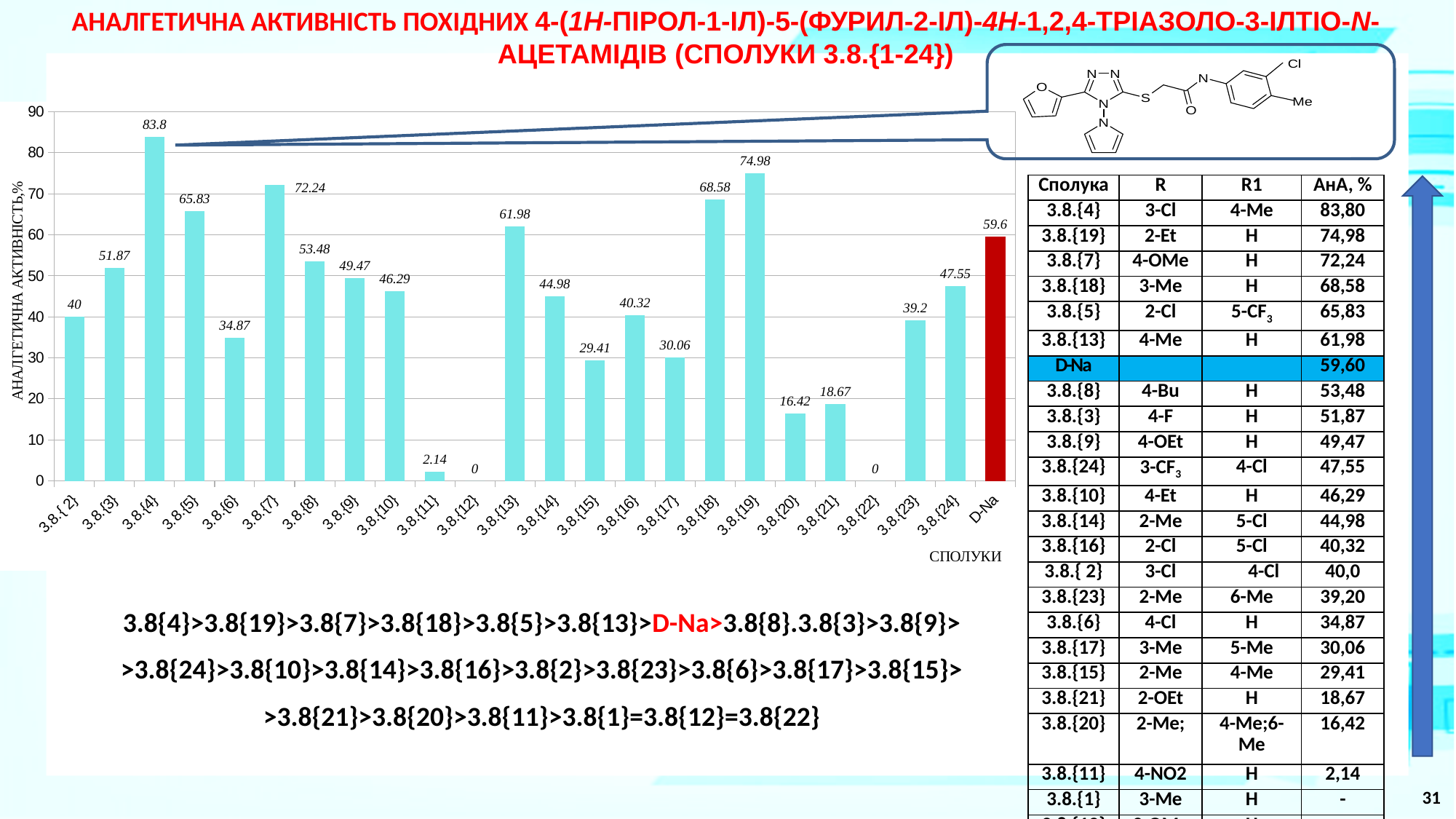
How many bars are plotted in the chart? 24 Which bar is coloured dark red instead of light blue? D-Na What kind of chart is shown? bar chart What is the value for 3.8.{19}? 74.98 Is the value for 3.8.{13} greater or less than 60? greater What is the difference between the values for 3.8.{4} and D-Na? 24.2 Which is larger, the value for 3.8.{7} or the value for 3.8.{18}? 3.8.{7} What is the value for D-Na? 59.6 What is the value for 3.8.{4}? 83.8 What is the difference between the values for 3.8.{21} and 3.8.{20}? 2.25 What is the value for 3.8.{11}? 2.14 Which category has the highest value? 3.8.{4}